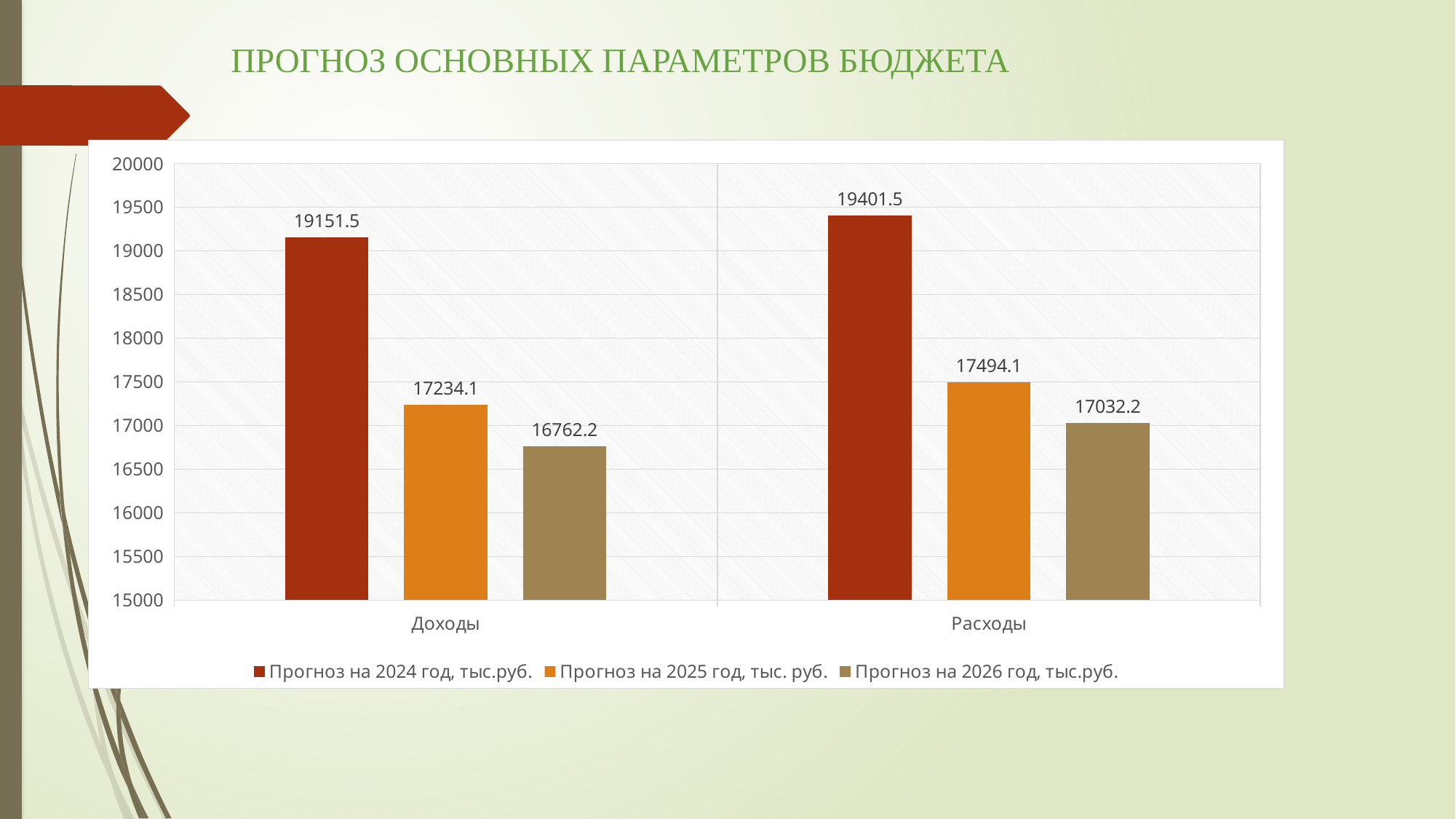
What is the value for Расходы in the series 'Прогноз на 2026 год, тыс.руб.'? 17032.2 What is the difference between Расходы and Доходы in the series 'Прогноз на 2024 год, тыс.руб.'? 250 How many categories are shown on the x axis? 2 Is the value for Доходы in the 2026 forecast greater or less than 17000? less What is the difference between the 2025 and 2026 forecast values for Доходы? 471.9 What kind of chart is shown on the slide? bar chart Which series has the highest value for Доходы? Прогноз на 2024 год, тыс.руб. Which is larger: Доходы or Расходы in the series 'Прогноз на 2026 год, тыс.руб.'? Расходы What is the value for Расходы in the series 'Прогноз на 2025 год, тыс. руб.'? 17494.1 How many series does the legend list? 3 What is the value for Доходы in the series 'Прогноз на 2024 год, тыс.руб.'? 19151.5 Which series has the lowest value for Расходы? Прогноз на 2026 год, тыс.руб.